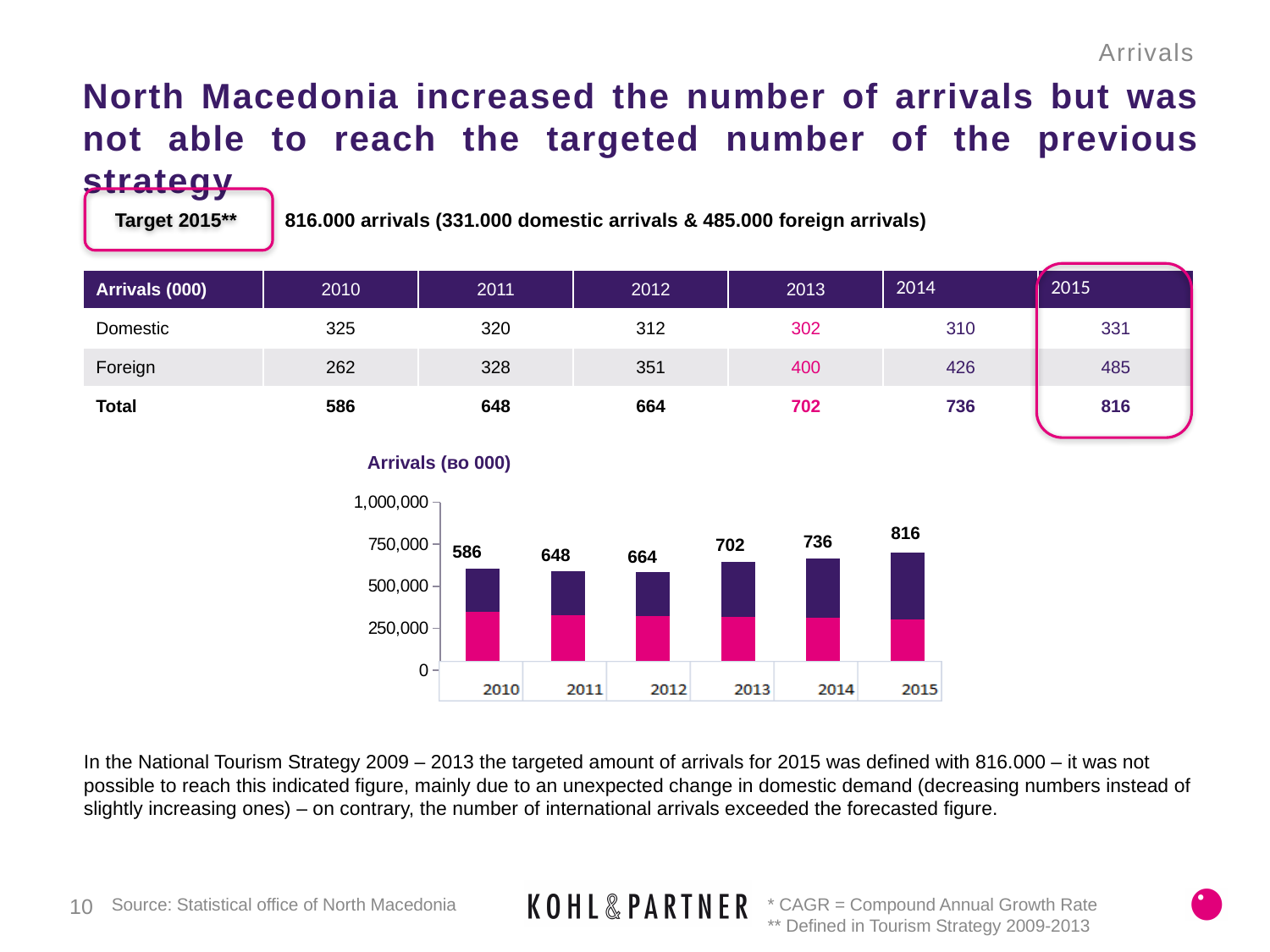
What is the title of the chart? Arrivals (во 000) Do the total arrivals values rise or fall from 2010 to 2015? rise Which year has a larger total arrivals value, 2012 or 2014? 2014 What is the total arrivals value labelled on the bar for 2015? 816 What is the difference between the total arrivals labelled for 2015 and 2010? 230 What is the total arrivals value labelled on the bar for 2013? 702 What is the total arrivals value labelled on the bar for 2010? 586 Which year has the highest total arrivals in the chart? 2015 Which year has the lowest total arrivals in the chart? 2010 What is the highest value shown on the y axis of the chart? 1,000,000 What type of chart is shown on the slide? bar chart How many years are shown on the x axis of the chart? 6